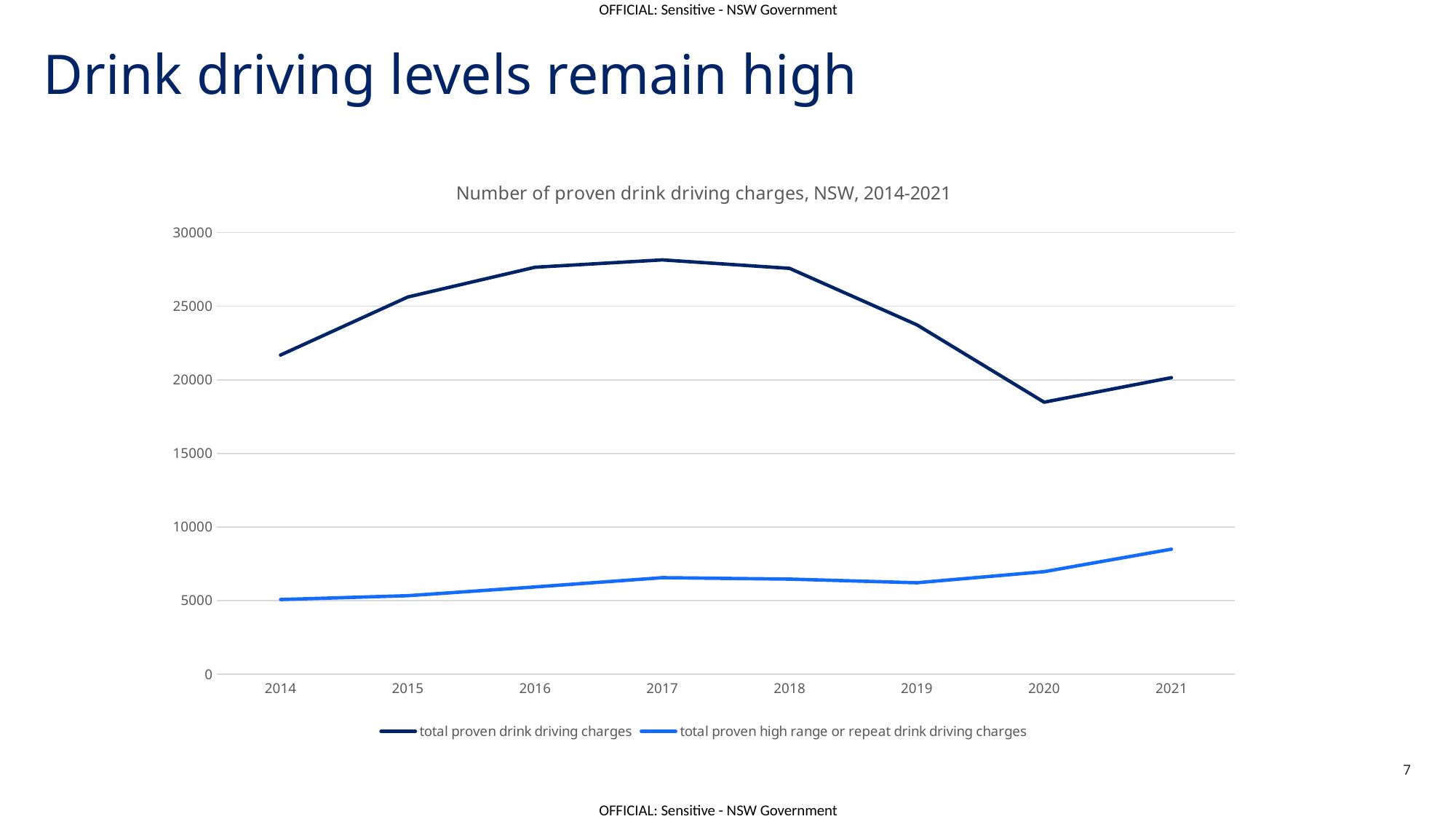
In which year is the value for total proven high range or repeat drink driving charges highest? 2021 What is the title of the chart? Number of proven drink driving charges, NSW, 2014-2021 What kind of chart is shown on the slide? line chart Is the value for total proven high range or repeat drink driving charges in 2021 greater or less than 10000? less Is the value for total proven drink driving charges in 2020 greater or less than 20000? less Is the value for total proven drink driving charges in 2017 greater or less than 25000? greater In which year is the value for total proven drink driving charges lowest? 2020 Which series is drawn in the lighter blue line? total proven high range or repeat drink driving charges Does the value for total proven drink driving charges rise or fall from 2017 to 2020? fall In which year is the value for total proven high range or repeat drink driving charges lowest? 2014 How many years are plotted along the x axis? 8 How many series does the legend list? 2